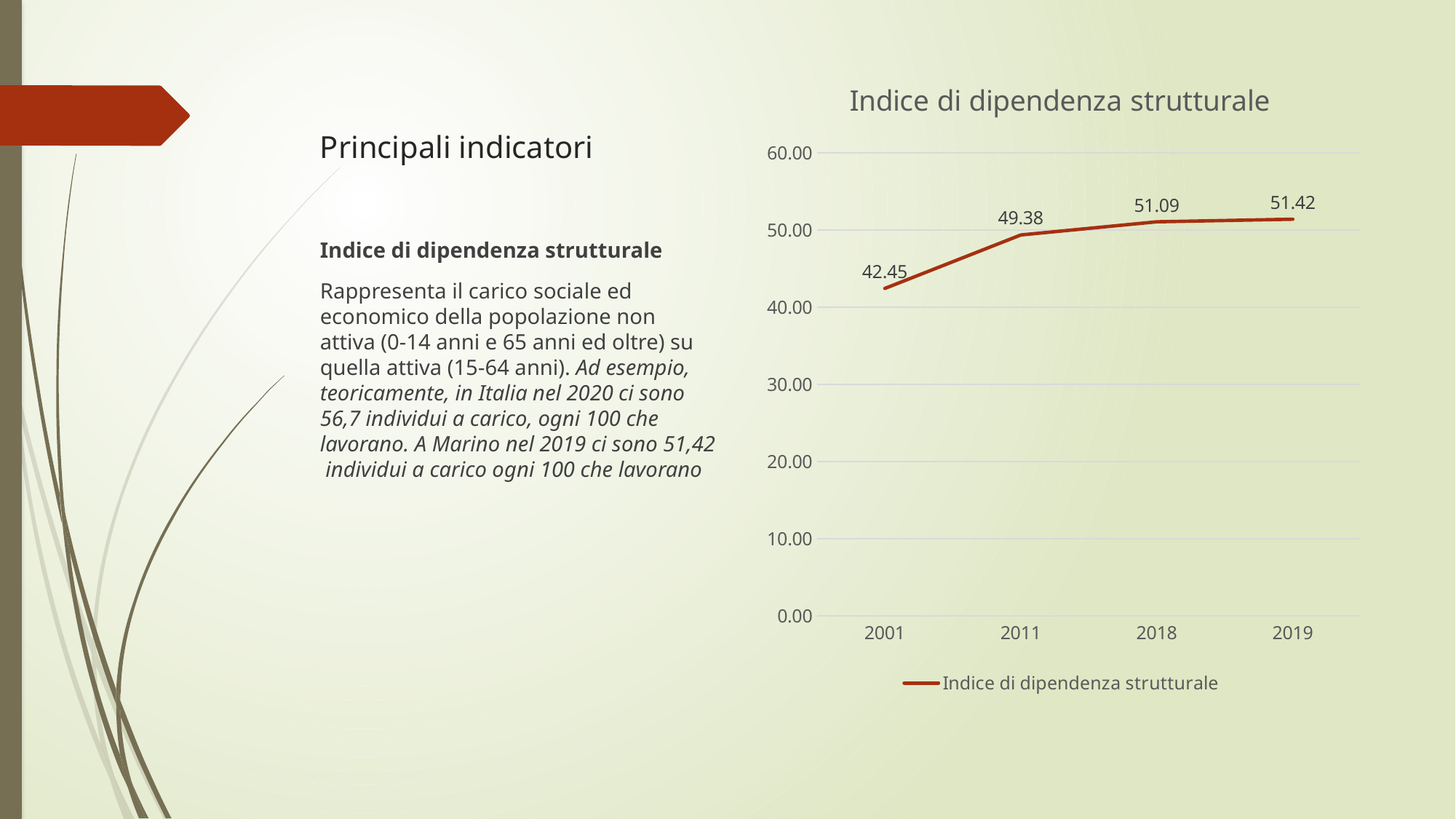
What is the value of the Indice di dipendenza strutturale in 2018? 51.09 Which year has the lowest value of the Indice di dipendenza strutturale? 2001 What kind of chart is shown on the slide? Line chart Does the Indice di dipendenza strutturale rise or fall from 2001 to 2019? Rise Which is larger, the value for 2001 or the value for 2011? 2011 What is the value of the Indice di dipendenza strutturale in 2019? 51.42 What is the difference between the 2011 and 2001 values of the Indice di dipendenza strutturale? 6.93 How many series does the chart legend list? 1 How many years are plotted on the x axis of the chart? 4 Which year has the highest value of the Indice di dipendenza strutturale? 2019 What is the value of the Indice di dipendenza strutturale in 2001? 42.45 What is the value of the Indice di dipendenza strutturale in 2011? 49.38